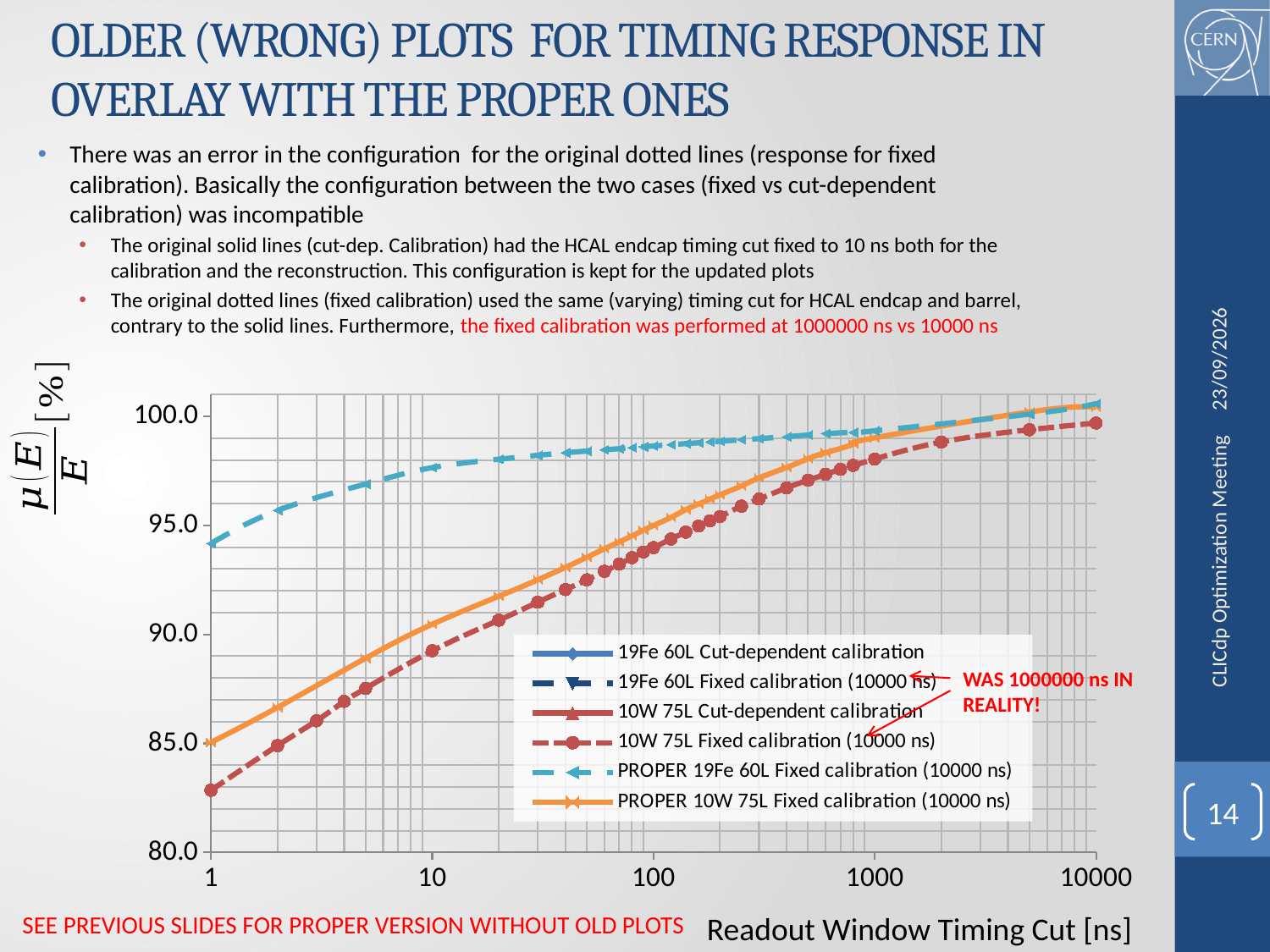
How many labelled tick values are shown on the x axis? 5 Is the value of the PROPER 19Fe 60L Fixed calibration (10000 ns) series at 10000 ns greater or less than 95.0? greater Is the value of the PROPER 10W 75L Fixed calibration (10000 ns) series at 1 ns greater or less than 90.0? less Do the plotted values rise or fall as the readout window timing cut increases along the x axis? rise At 1 ns, which is higher: the PROPER 19Fe 60L Fixed calibration (10000 ns) series or the PROPER 10W 75L Fixed calibration (10000 ns) series? PROPER 19Fe 60L Fixed calibration (10000 ns) What is the title of the x axis? Readout Window Timing Cut [ns] At 1 ns, which is higher: the PROPER 10W 75L Fixed calibration (10000 ns) series or the 10W 75L Fixed calibration (10000 ns) series? PROPER 10W 75L Fixed calibration (10000 ns) Which series in the legend is drawn as a solid orange line? PROPER 10W 75L Fixed calibration (10000 ns) Is the value of the PROPER 19Fe 60L Fixed calibration (10000 ns) series at 1 ns greater or less than 95.0? less What kind of chart is shown on the slide? line chart How many series does the legend list? 6